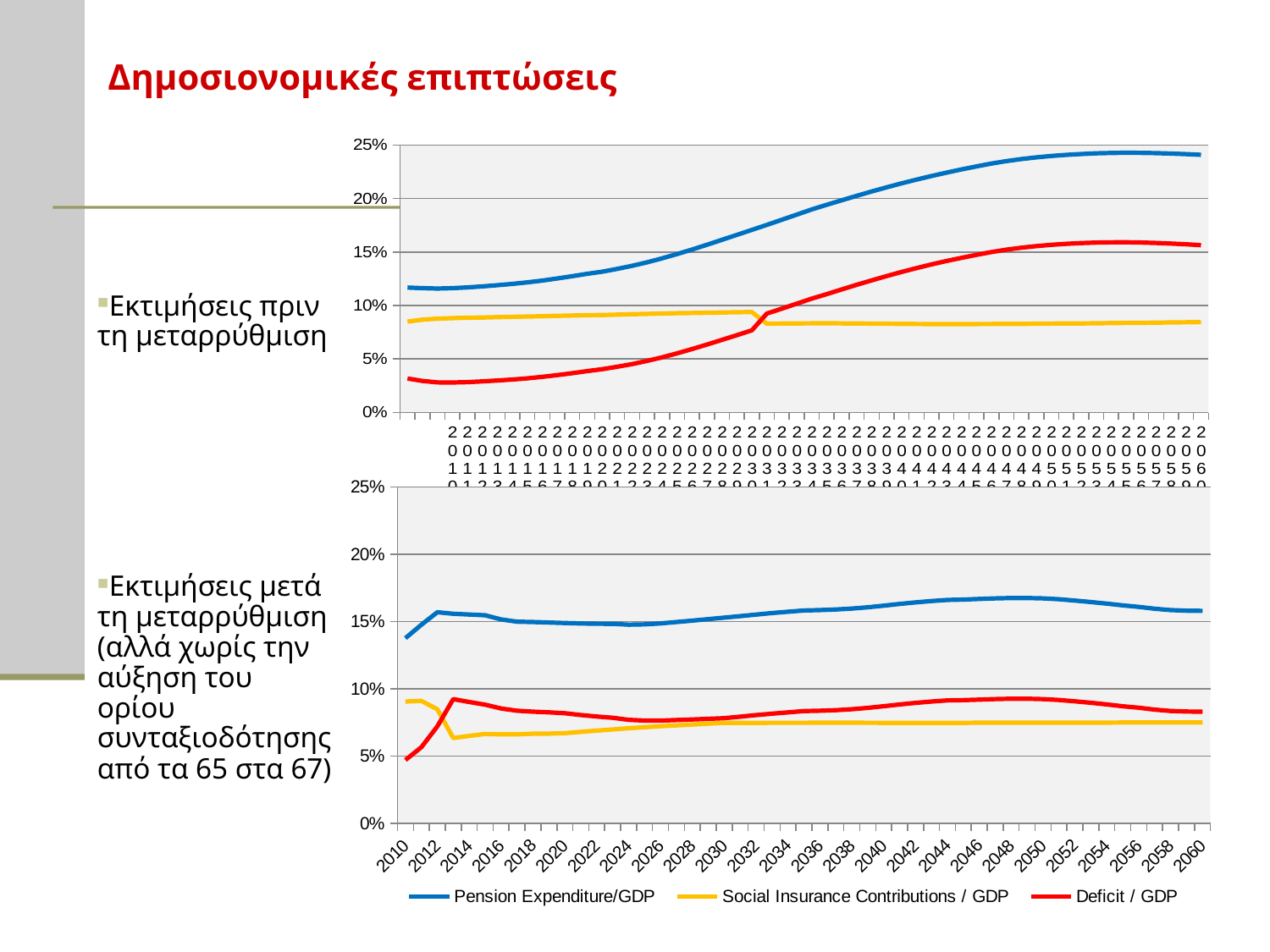
In the top chart (before the reform), is the value of Deficit / GDP in 2010 greater or less than 5%? less Which series reaches the highest value in the top chart (before the reform)? Pension Expenditure/GDP What kind of chart is the top chart (Εκτιμήσεις πριν τη μεταρρύθμιση)? Line chart In the top chart (before the reform), does Pension Expenditure/GDP generally rise or fall from 2010 to 2060? rise Which series is drawn in red in the charts? Deficit / GDP In the top chart (before the reform), is the value of Pension Expenditure/GDP in 2060 greater or less than 20%? greater In the bottom chart (after the reform), is the value of Pension Expenditure/GDP in 2060 greater or less than 15%? greater In the top chart (before the reform), which is larger in 2060: Deficit / GDP or Social Insurance Contributions / GDP? Deficit / GDP In the bottom chart (after the reform), which is larger in 2060: Pension Expenditure/GDP or Deficit / GDP? Pension Expenditure/GDP How many series does the legend at the bottom of the slide list? 3